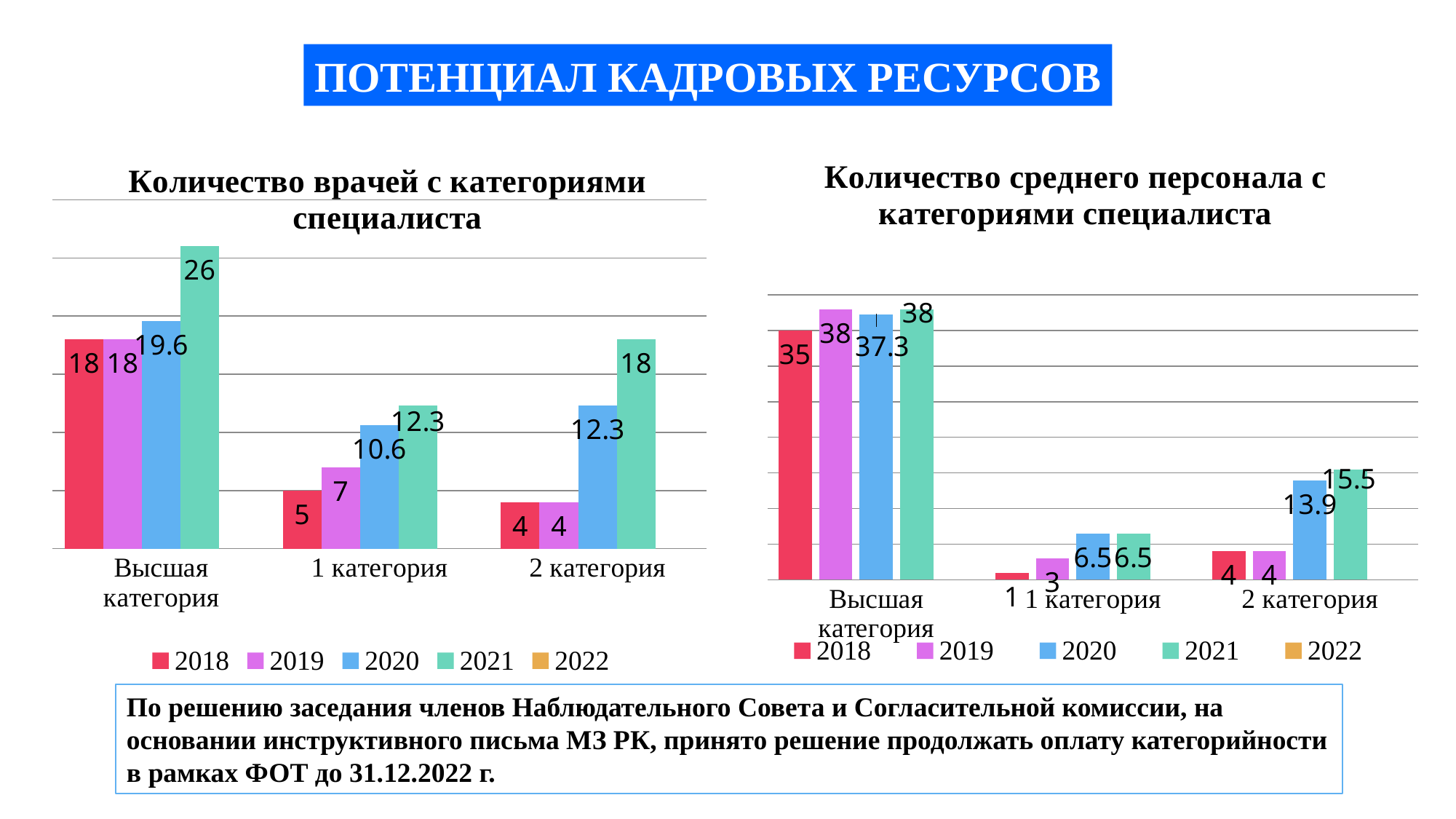
In the chart 'Количество среднего персонала с категориями специалиста', what is the value for 2020 in the '2 категория' group? 13.9 In the chart 'Количество среднего персонала с категориями специалиста', which year has the lowest value in the '1 категория' group? 2018 In the chart 'Количество врачей с категориями специалиста', what is the value for 2020 in the '1 категория' group? 10.6 In the chart 'Количество среднего персонала с категориями специалиста', what is the difference between the 2019 and 2018 values in the 'Высшая категория' group? 3 In the chart 'Количество врачей с категориями специалиста', which year has the highest value in the '2 категория' group? 2021 In the chart 'Количество среднего персонала с категориями специалиста', what is the value for 2018 in the 'Высшая категория' group? 35 In the chart 'Количество врачей с категориями специалиста', what is the difference between the 2021 and 2018 values in the '1 категория' group? 7.3 In the chart 'Количество врачей с категориями специалиста', how many categories are shown on the x axis? 3 What type of chart is 'Количество среднего персонала с категориями специалиста'? bar chart In the chart 'Количество врачей с категориями специалиста', what is the value for 2021 in the 'Высшая категория' group? 26 In the chart 'Количество среднего персонала с категориями специалиста', is the 2021 value in the '2 категория' group larger or smaller than the 2020 value in the same group? larger How many series does the legend of the chart 'Количество врачей с категориями специалиста' list? 5